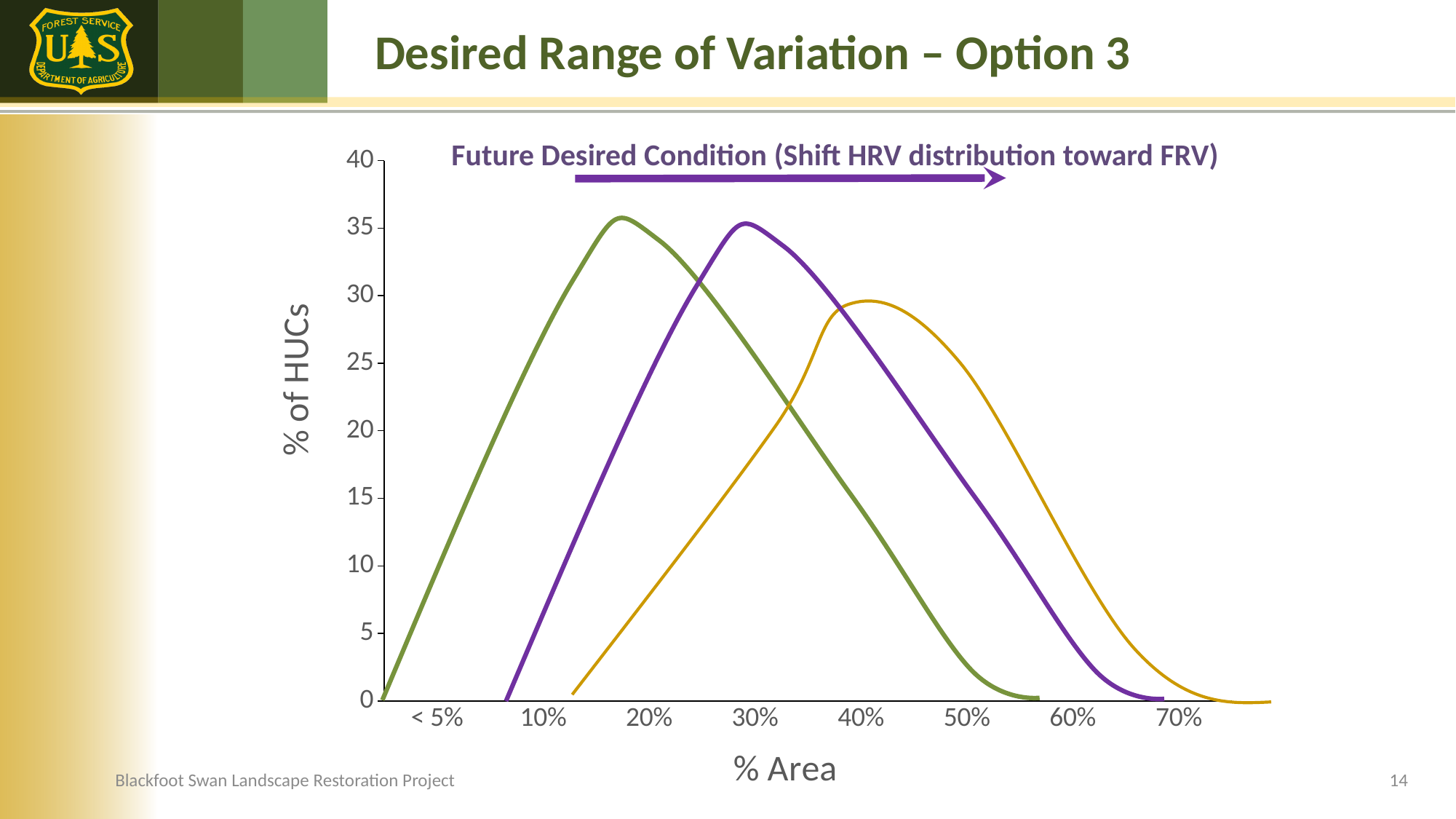
What is the title of the x axis? % Area What kind of chart is shown on the slide? line chart How many curves (lines) are plotted on the chart? 3 Which curve reaches its peak furthest to the right along the x axis? gold Does the green curve rise or fall between 20% and 50% on the x axis? fall How many labelled tick marks are on the x axis of the chart? 8 What is the highest value labelled on the y axis? 40 Is the peak value of the purple curve greater or less than 30? greater Is the peak value of the gold curve greater or less than 25? greater Which curve has the lowest peak: green, purple or gold? gold Is the peak value of the green curve greater or less than 30? greater What is the title of the y axis? % of HUCs